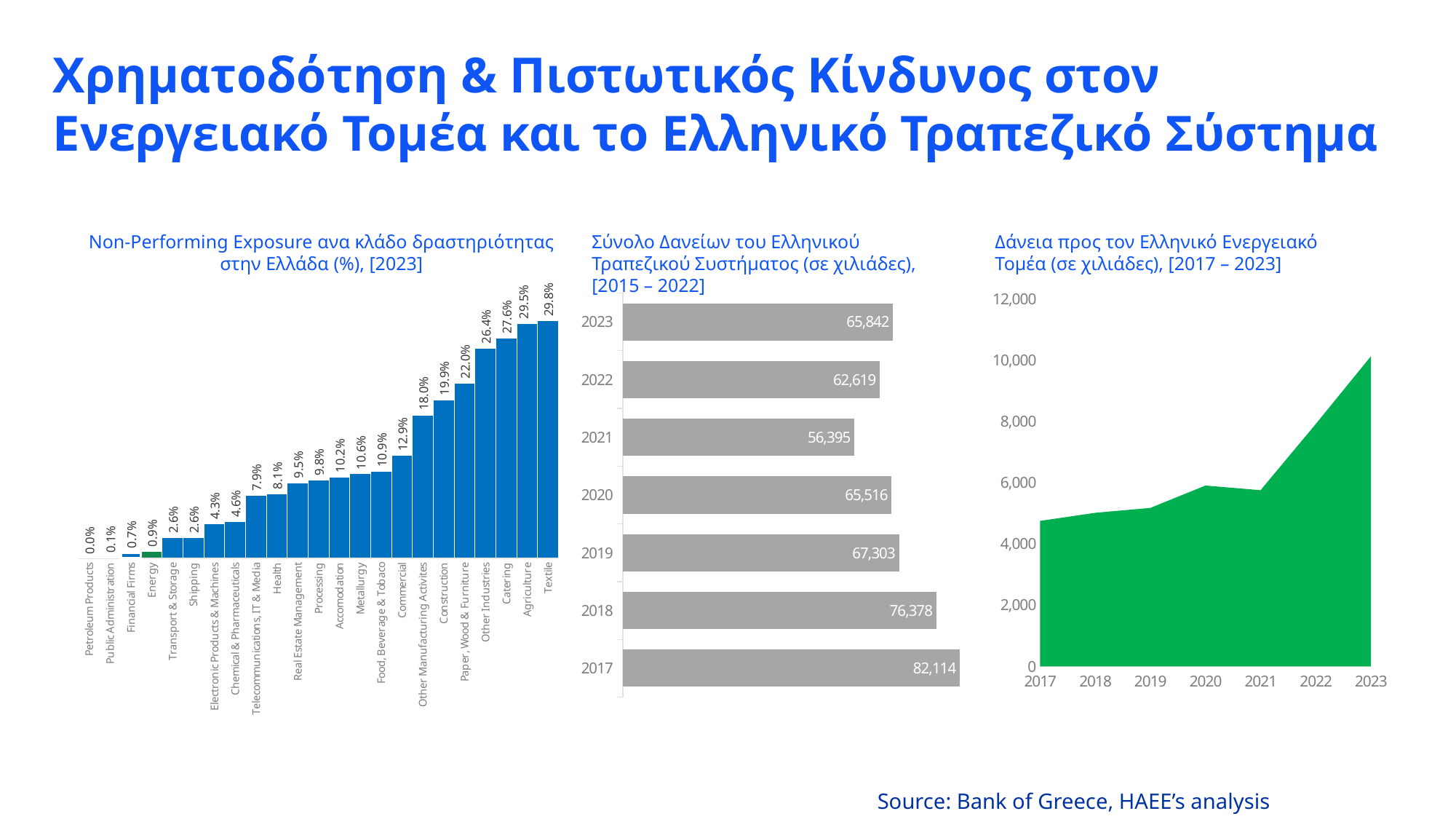
In the right chart of loans to the Greek energy sector, is the value for 2023 greater or less than 8,000? greater In the Non-Performing Exposure chart on the left, what is the value for Energy? 0.9% In the Non-Performing Exposure chart on the left, what is the value for Construction? 19.9% In the right chart of loans to the Greek energy sector, do the values generally rise or fall from 2017 to 2023? rise In the middle chart of total loans of the Greek banking system, which is larger, 2020 or 2023? 2023 In the middle chart of total loans of the Greek banking system, which year has the highest value? 2017 In the middle chart of total loans of the Greek banking system, what is the difference between 2017 and 2018? 5,736 In the Non-Performing Exposure chart on the left, how many sectors are shown? 23 In the Non-Performing Exposure chart on the left, what is the difference between Agriculture and Catering? 1.9% In the middle chart of total loans of the Greek banking system, which year has the lowest value? 2021 In the middle chart of total loans of the Greek banking system, what is the value for 2021? 56,395 In the Non-Performing Exposure chart on the left, which sector has the highest value? Textile